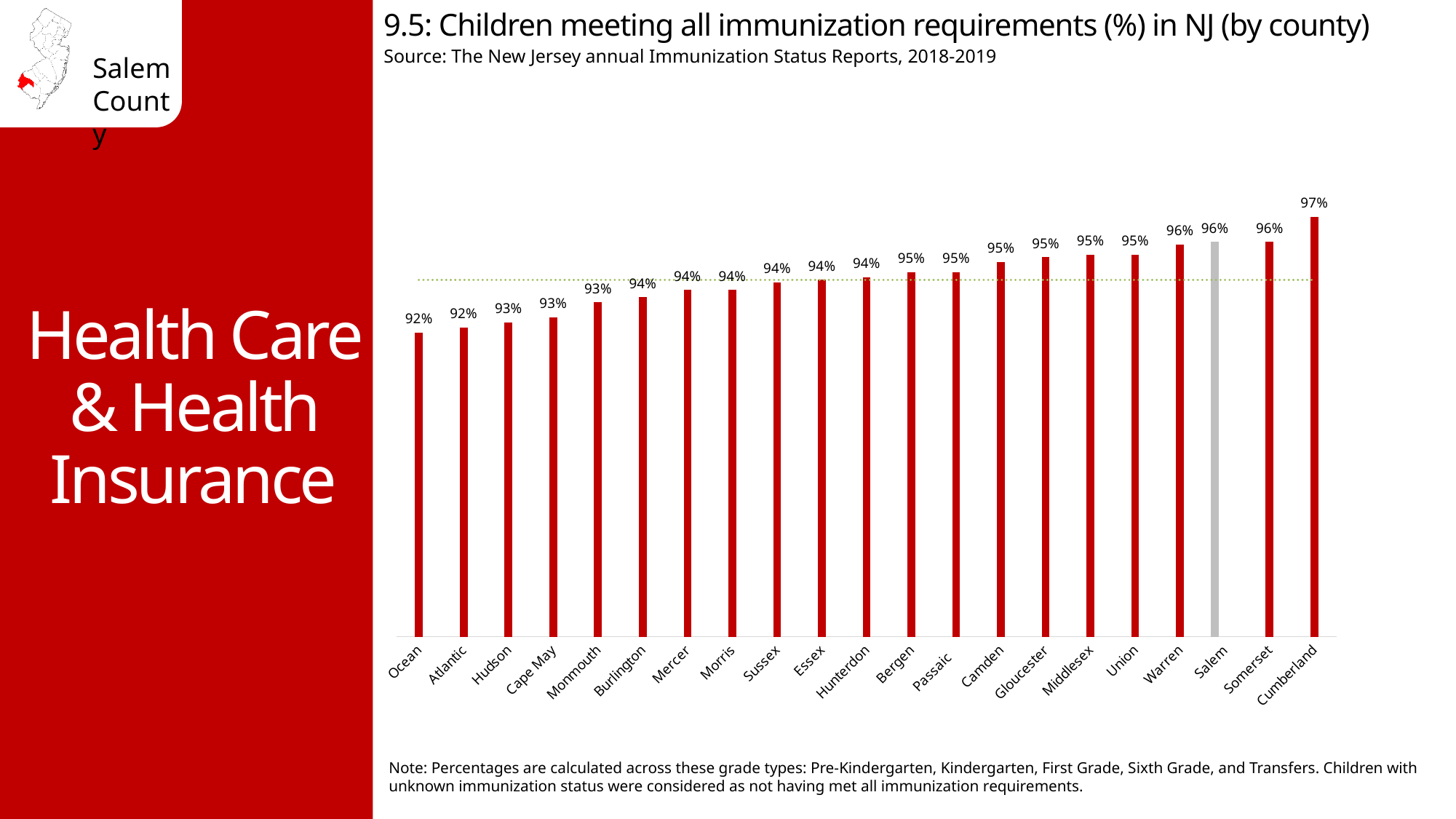
How many counties are shown in the chart? 21 Which has a higher value, Salem or Hudson? Salem What is the value shown for Hunterdon County? 94% Do the values rise or fall from left to right across the counties? Rise Which county has the highest percentage of children meeting all immunization requirements? Cumberland What kind of chart is shown on the slide? Bar chart Which has a higher value, Cumberland or Monmouth? Cumberland What percentage of children in Salem County met all immunization requirements? 96% What is the value shown for Middlesex County? 95% What is the value shown for Ocean County? 92% What is the difference in percentage points between Cumberland and Ocean counties? 5 percentage points What is the difference in percentage points between Salem and Ocean counties? 4 percentage points